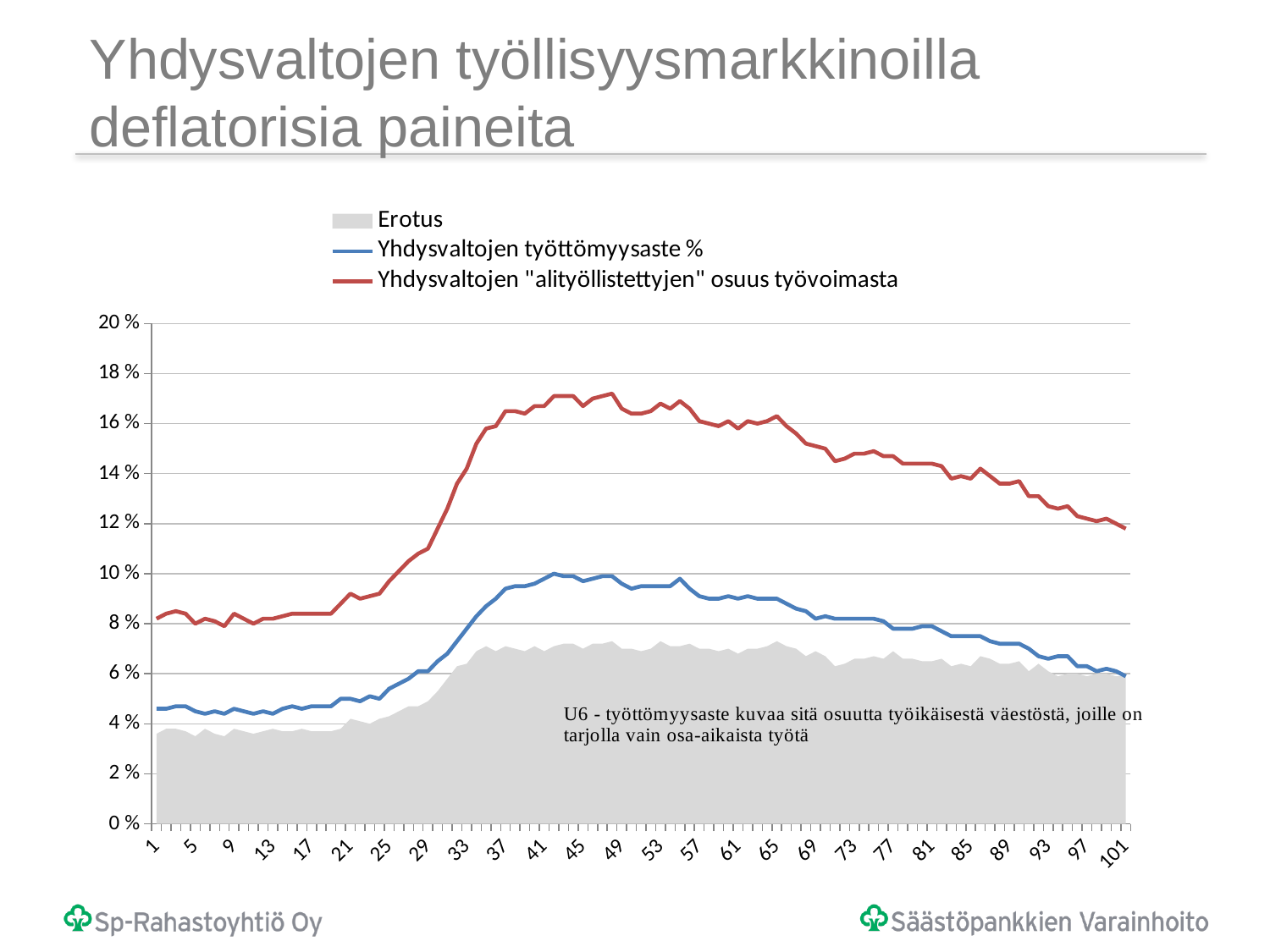
Is the value of Yhdysvaltojen "alityöllistettyjen" osuus työvoimasta at point 29 greater or less than 10%? greater Does Yhdysvaltojen "alityöllistettyjen" osuus työvoimasta rise or fall from point 49 to point 101? fall Which series reaches the highest value on the chart? Yhdysvaltojen "alityöllistettyjen" osuus työvoimasta Which series is drawn in red? Yhdysvaltojen "alityöllistettyjen" osuus työvoimasta How many series does the legend list? 3 Which series is higher at point 61, Yhdysvaltojen työttömyysaste % or Yhdysvaltojen "alityöllistettyjen" osuus työvoimasta? Yhdysvaltojen "alityöllistettyjen" osuus työvoimasta Which series is shown as a grey shaded area? Erotus Is the value of Yhdysvaltojen "alityöllistettyjen" osuus työvoimasta at point 45 greater or less than 16%? greater Is the value of Yhdysvaltojen "alityöllistettyjen" osuus työvoimasta at point 101 greater or less than 14%? less What kind of chart is shown on the slide? area and line chart